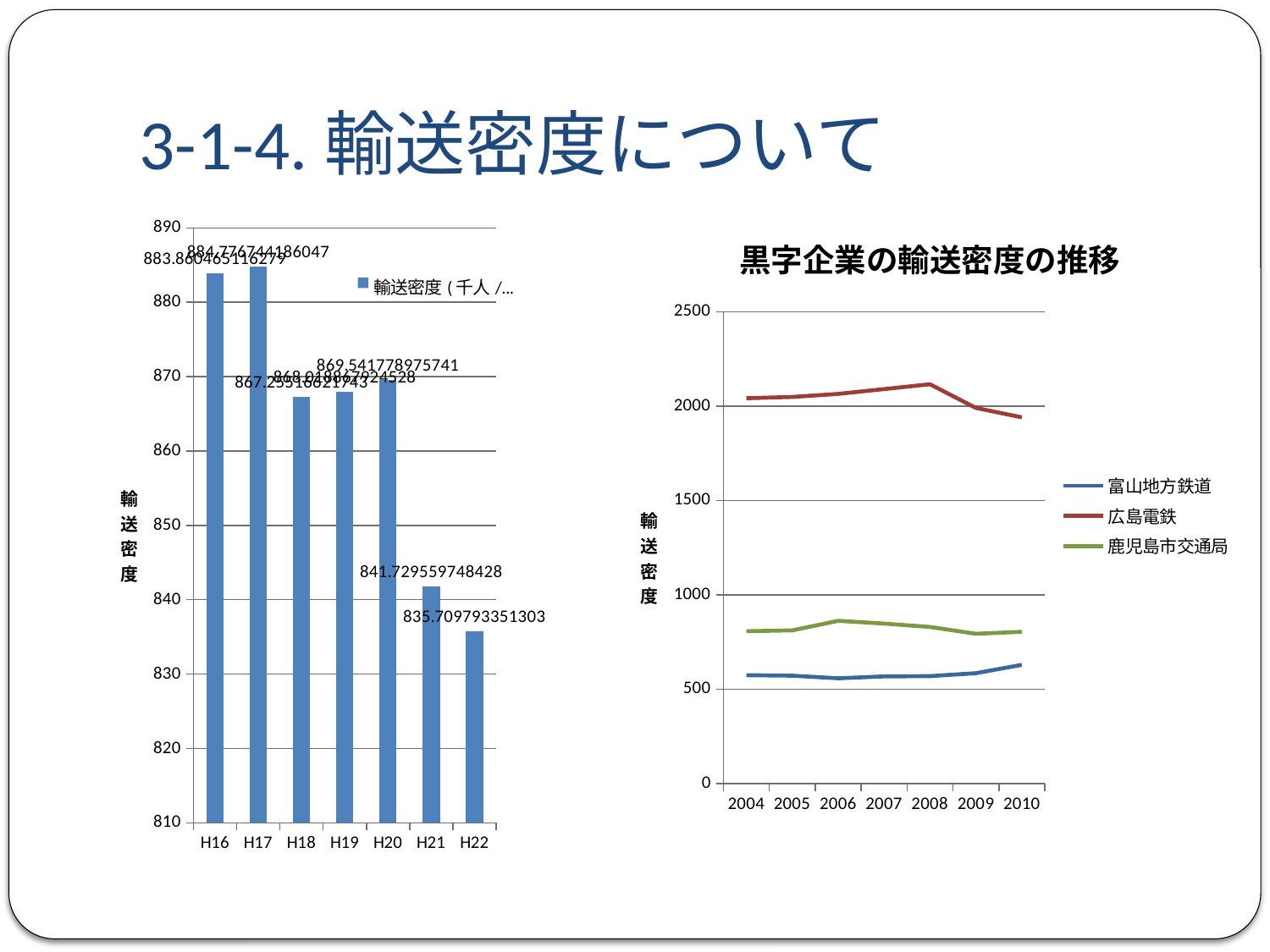
On the left bar chart, which category has the highest value? H17 How many series does the legend of the chart titled 黒字企業の輸送密度の推移 list? 3 On the left bar chart, what is the value for H22? 835.709793351303 In the chart titled 黒字企業の輸送密度の推移, which series has the highest values across all years? 広島電鉄 In the chart titled 黒字企業の輸送密度の推移, is the value for 広島電鉄 in 2008 greater or less than 2000? greater What kind of chart is the chart titled 黒字企業の輸送密度の推移? line chart On the left bar chart, do the values generally rise or fall from H16 to H22? fall On the left bar chart, which category has the lowest value? H22 On the left bar chart, how many categories are shown on the x axis? 7 On the left bar chart, what is the value for H20? 869.541778975741 In the chart titled 黒字企業の輸送密度の推移, is the value for 鹿児島市交通局 in 2006 greater or less than 1000? less On the left bar chart, what is the value for H21? 841.729559748428